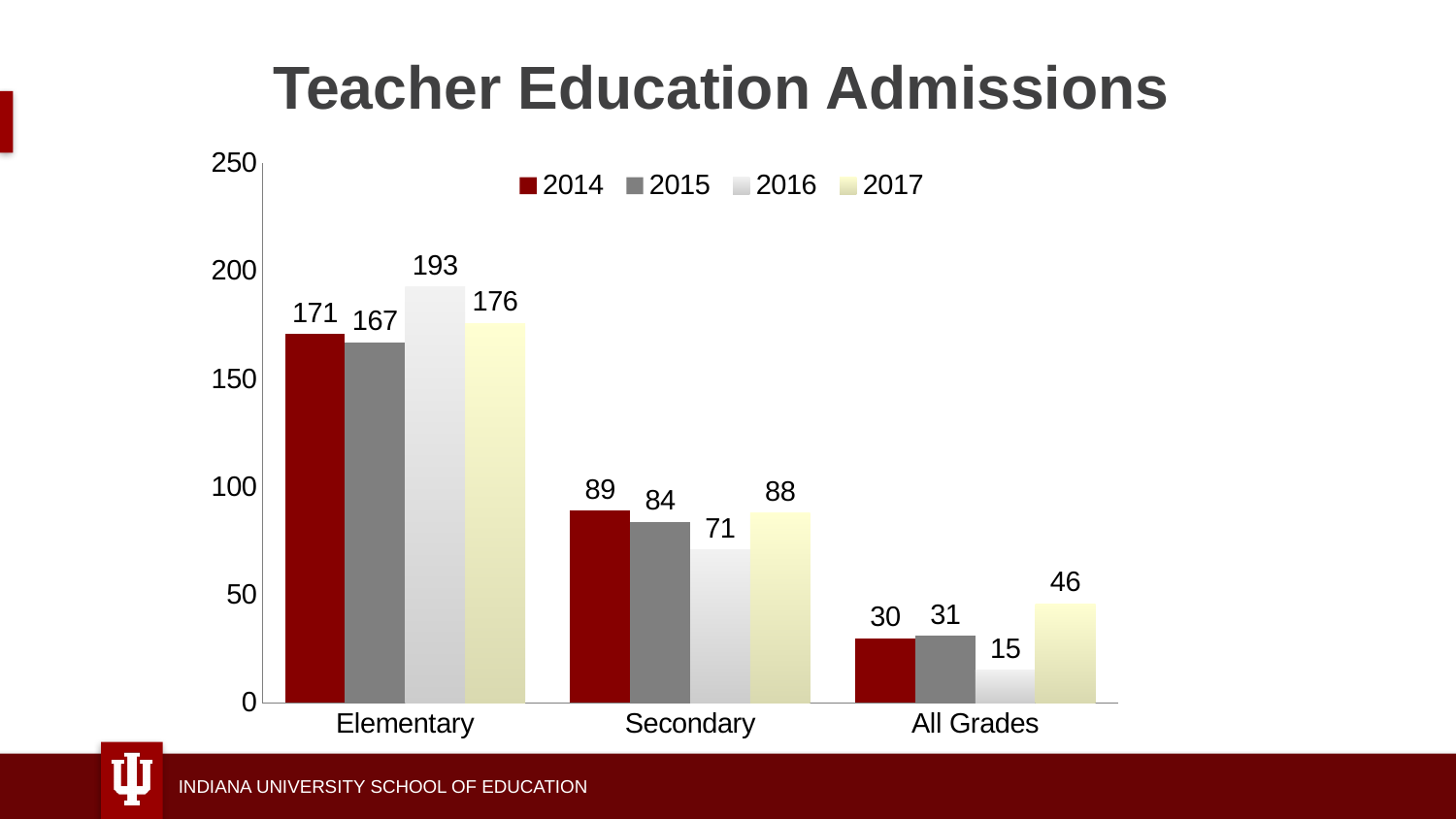
What was the number of All Grades admissions in 2017? 46 How many categories are shown on the x axis? 3 What is the title of the chart? Teacher Education Admissions What kind of chart is shown on the slide? Bar chart Which is larger: Secondary admissions in 2014 or in 2017? 2014 What was the number of Elementary admissions in 2016? 193 What is the difference between Elementary admissions in 2016 and 2015? 26 What was the number of Secondary admissions in 2015? 84 How many series does the legend list? 4 Which year had the highest Elementary admissions? 2016 Which year had the lowest All Grades admissions? 2016 What is the difference between All Grades admissions in 2017 and 2016? 31